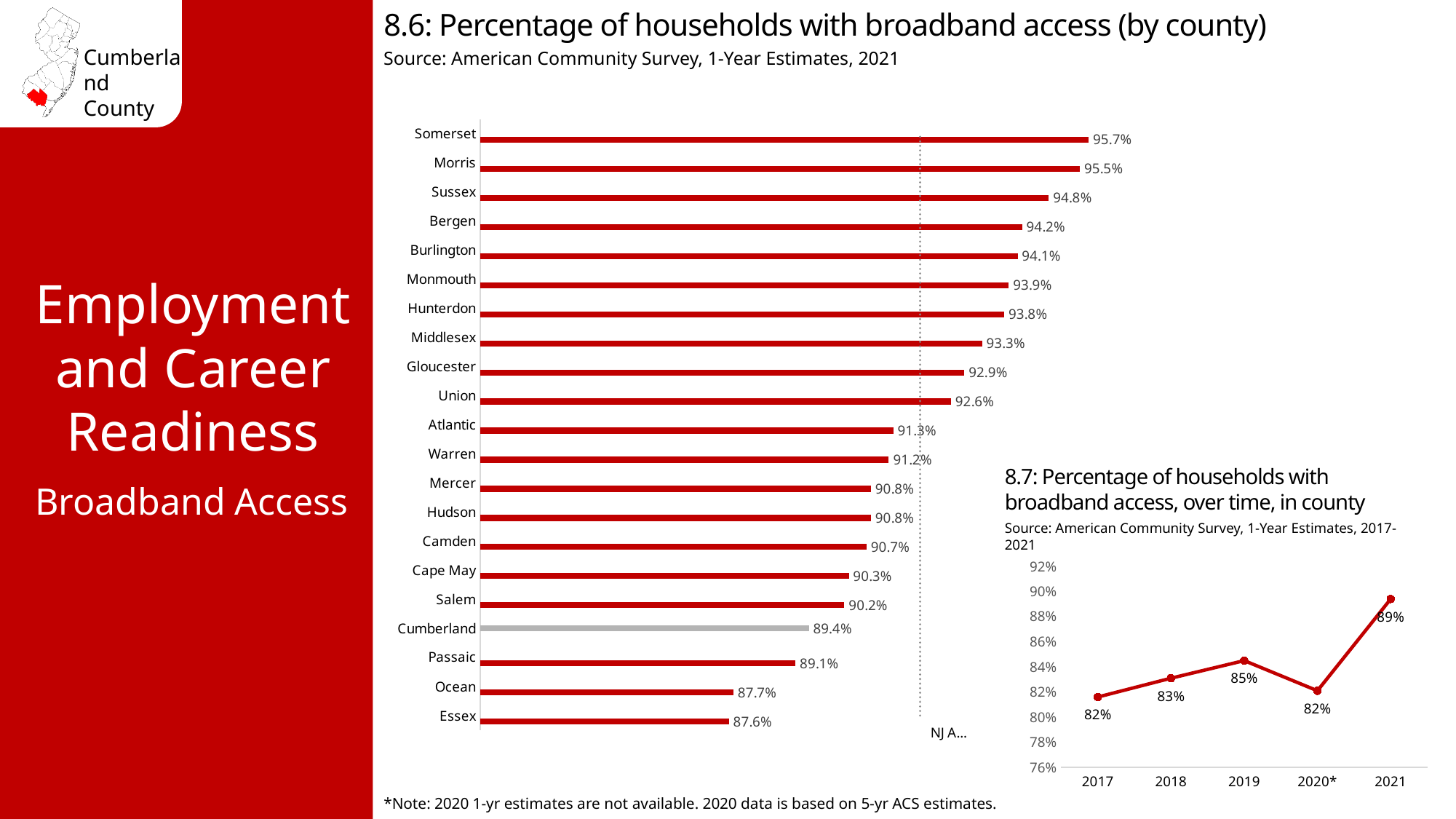
In chart 8.6 (percentage of households with broadband access by county), what is the value for Cumberland? 89.4% What kind of chart is chart 8.6 (percentage of households with broadband access by county)? Bar chart In chart 8.6 (by county), what is the difference between Somerset's value and Cumberland's value? 6.3% In chart 8.6 (by county), how many counties are shown? 21 In chart 8.6 (by county), which county has the highest percentage of households with broadband access? Somerset In chart 8.7 (broadband access over time in county), what is the value for 2019? 85% In chart 8.6 (by county), which county has the lowest percentage of households with broadband access? Essex What kind of chart is chart 8.7 (broadband access over time in county)? Line chart In chart 8.6 (by county), what is the value for Passaic? 89.1% In chart 8.7 (broadband access over time in county), which year has the highest value? 2021 In chart 8.6 (by county), which has a higher value, Gloucester or Salem? Gloucester In chart 8.7 (broadband access over time in county), how many data points are plotted? 5